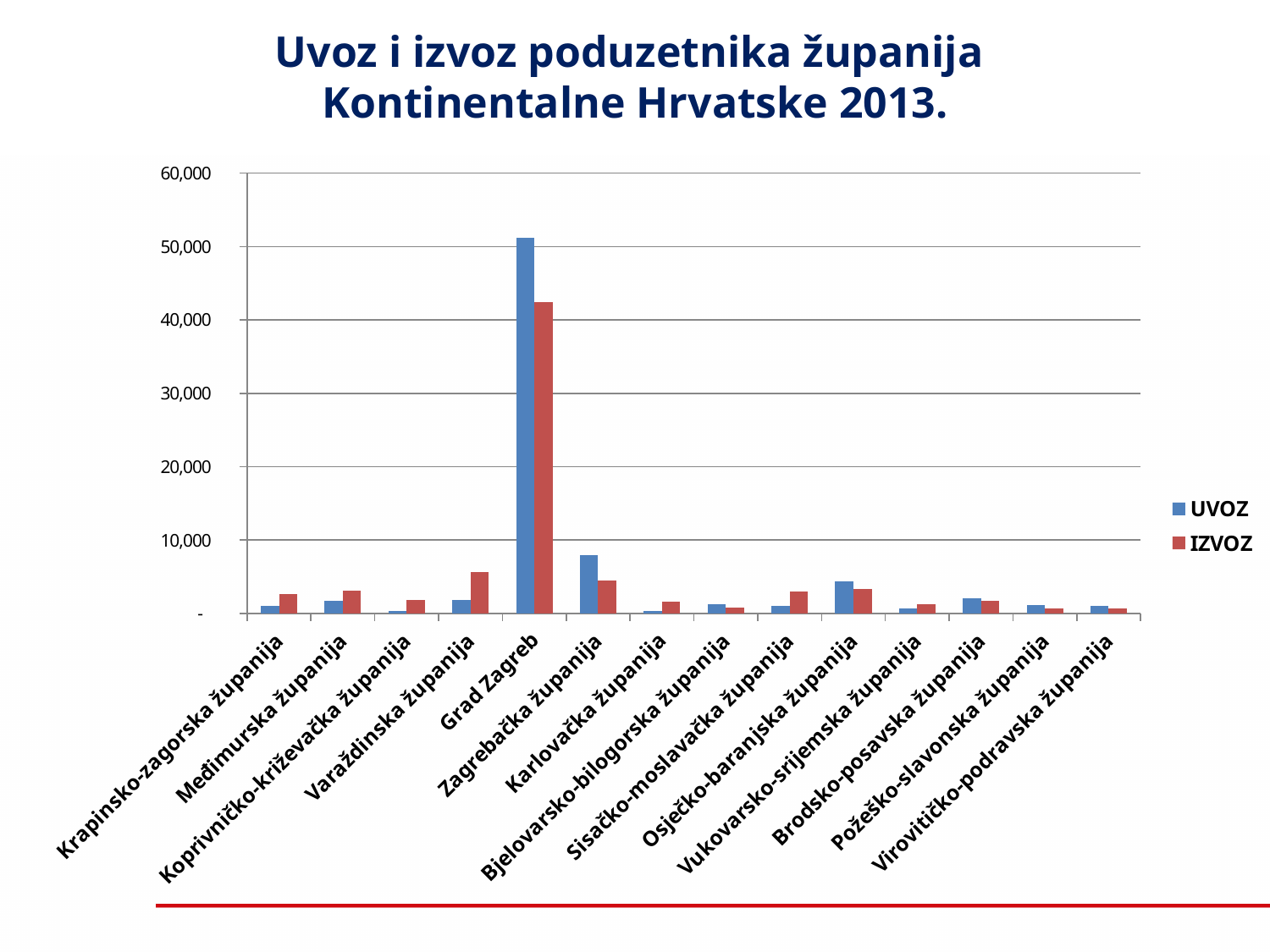
For Grad Zagreb, which is larger, UVOZ or IZVOZ? UVOZ Is the UVOZ value for Zagrebačka županija greater or less than 10,000? less Is the IZVOZ value for Grad Zagreb greater or less than 40,000? greater Which category has the highest IZVOZ value? Grad Zagreb What colour represents the IZVOZ series in the legend? Red Is the UVOZ value for Grad Zagreb greater or less than 40,000? greater Which category has the highest UVOZ value? Grad Zagreb For Varaždinska županija, which is larger, UVOZ or IZVOZ? IZVOZ How many counties (categories) are shown on the x axis? 14 What kind of chart is shown on the slide? Bar chart How many series does the legend list? 2 For Sisačko-moslavačka županija, which is larger, UVOZ or IZVOZ? IZVOZ